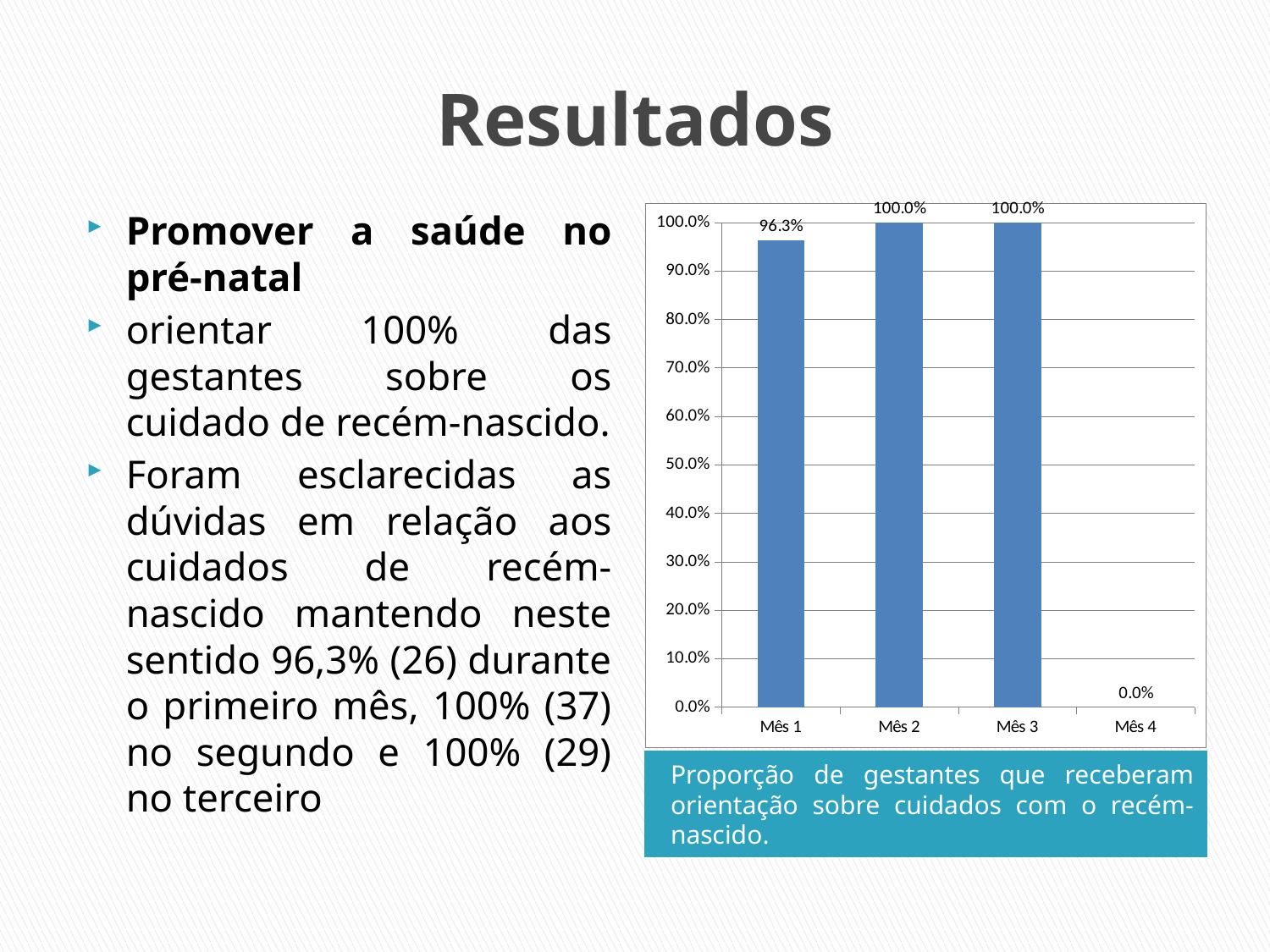
What colour are the bars in the chart? Blue What is the value for Mês 2? 100.0% What is the value for Mês 4? 0.0% Which category has the lowest value? Mês 4 Is the value for Mês 1 greater or less than 90.0%? greater What kind of chart is shown on the slide? bar chart Do the values for Mês 2 and Mês 3 differ? No, both are 100.0% How many categories are shown on the x axis? 4 Which is larger, the value for Mês 1 or the value for Mês 3? Mês 3 What is the highest value shown on the y axis? 100.0% What is the value for Mês 1? 96.3% What is the difference between the values for Mês 2 and Mês 1? 3.7%